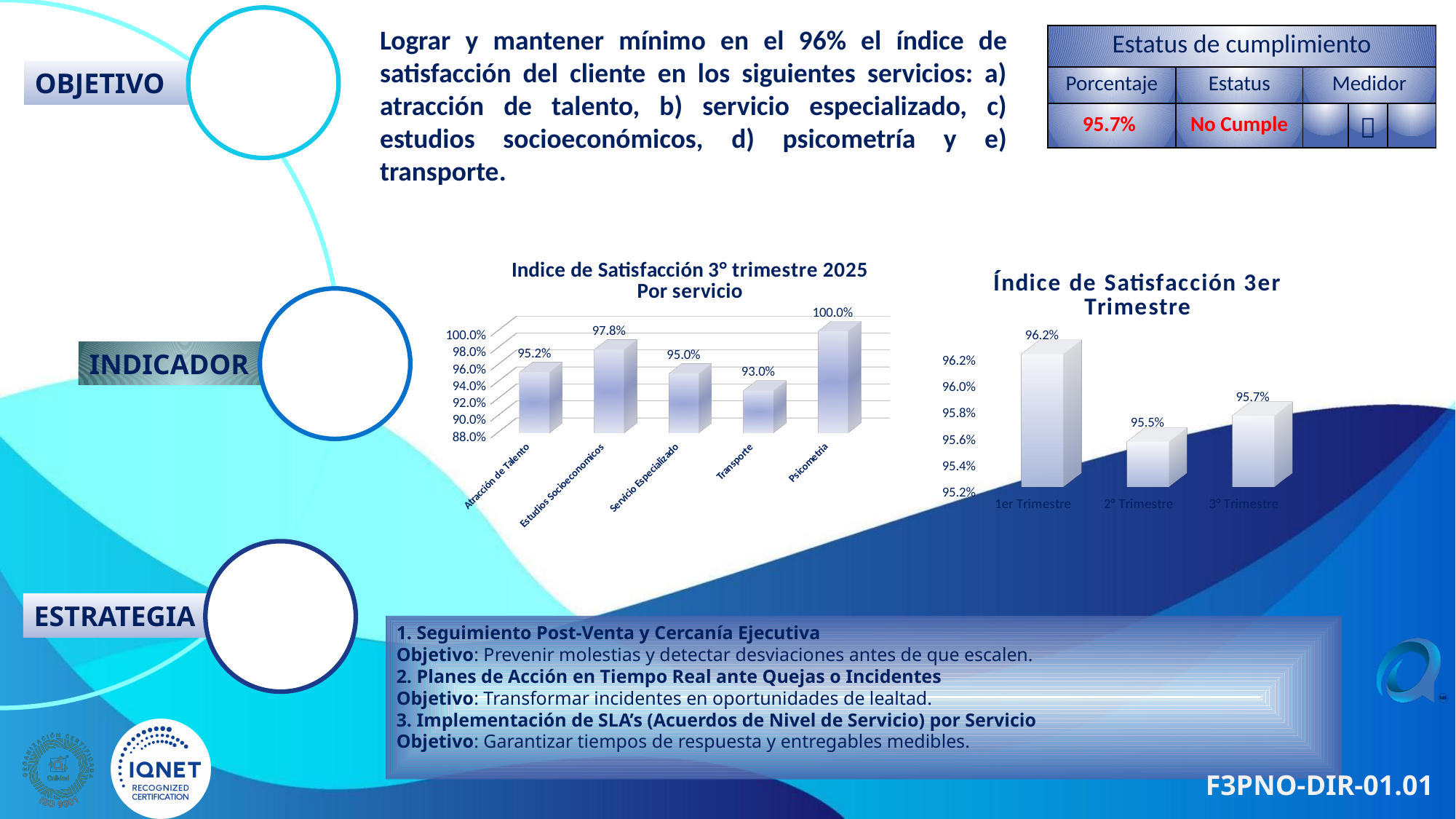
In the chart 'Índice de Satisfacción 3er Trimestre', what is the value for 2° Trimestre? 95.5% In the chart 'Indice de Satisfacción 3° trimestre 2025 Por servicio', what is the difference between Psicometría and Transporte? 7.0% In the chart 'Índice de Satisfacción 3er Trimestre', which quarter has the highest value? 1er Trimestre In the chart 'Indice de Satisfacción 3° trimestre 2025 Por servicio', which service has the lowest value? Transporte In the chart 'Indice de Satisfacción 3° trimestre 2025 Por servicio', which is larger, Atracción de Talento or Servicio Especializado? Atracción de Talento In the chart 'Índice de Satisfacción 3er Trimestre', is the value for 3° Trimestre greater or less than 96.0%? less In the chart 'Indice de Satisfacción 3° trimestre 2025 Por servicio', which service has the highest value? Psicometría In the chart 'Indice de Satisfacción 3° trimestre 2025 Por servicio', what is the value for Estudios Socioeconomicos? 97.8% In the chart 'Índice de Satisfacción 3er Trimestre', what is the difference between 1er Trimestre and 3° Trimestre? 0.5% How many services are shown in the chart 'Indice de Satisfacción 3° trimestre 2025 Por servicio'? 5 What kind of chart is 'Índice de Satisfacción 3er Trimestre'? Bar chart In the chart 'Indice de Satisfacción 3° trimestre 2025 Por servicio', what is the value for Transporte? 93.0%